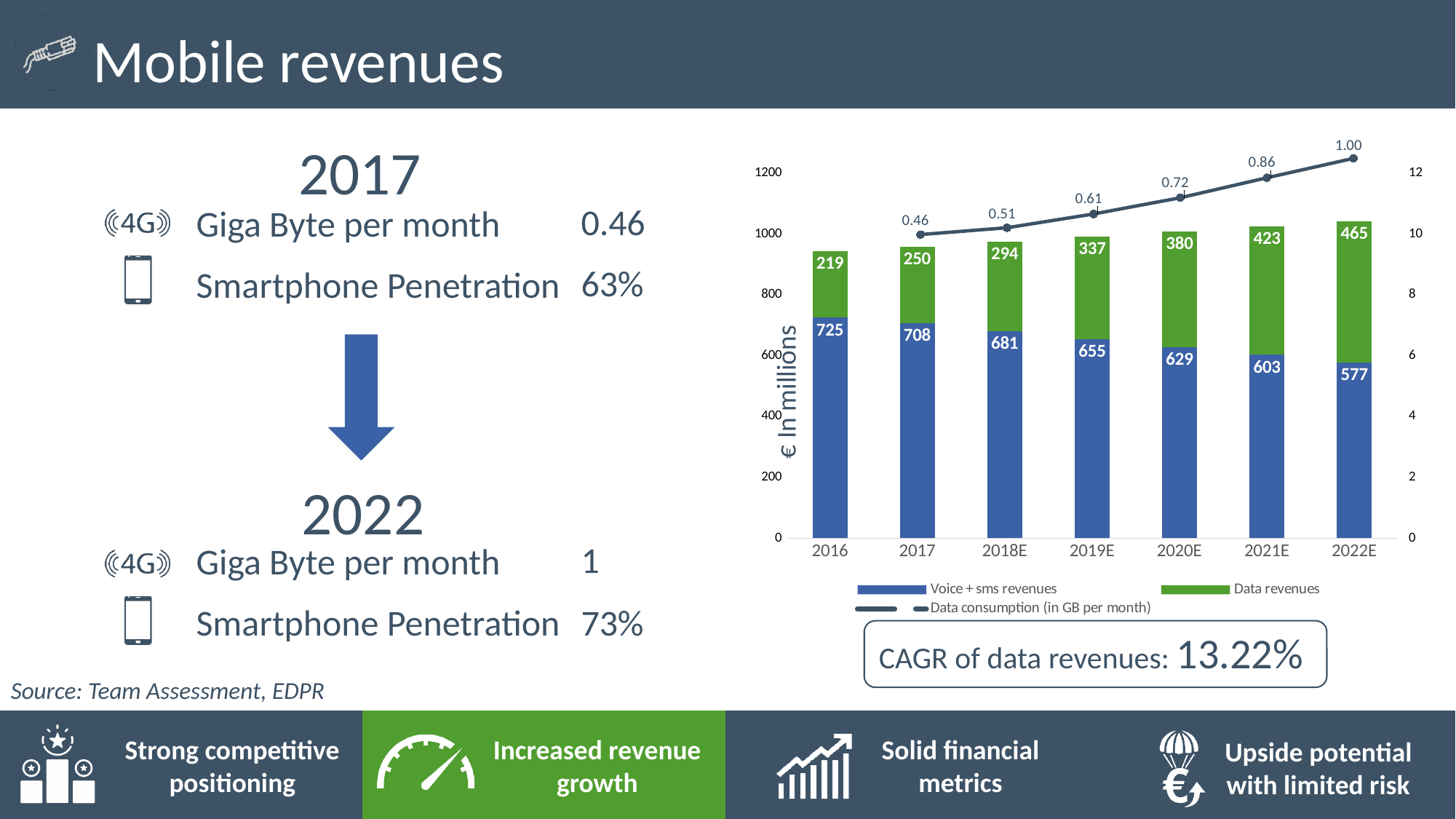
What is the difference between Voice + sms revenues in 2016 and 2022E? 148 What is the Data revenues value for 2022E? 465 Which year has the lowest Voice + sms revenues? 2022E How many years are shown on the x axis? 7 What is the label of the vertical axis on the left? € In millions Which is larger in 2020E: Voice + sms revenues or Data revenues? Voice + sms revenues What is the Data consumption (in GB per month) value for 2019E? 0.61 Which year has the highest Data revenues? 2022E What is the Voice + sms revenues value for 2016? 725 How many series does the legend list? 3 What is the total of the stacked bar for 2017? 958 Do Voice + sms revenues rise or fall from 2016 to 2022E? fall